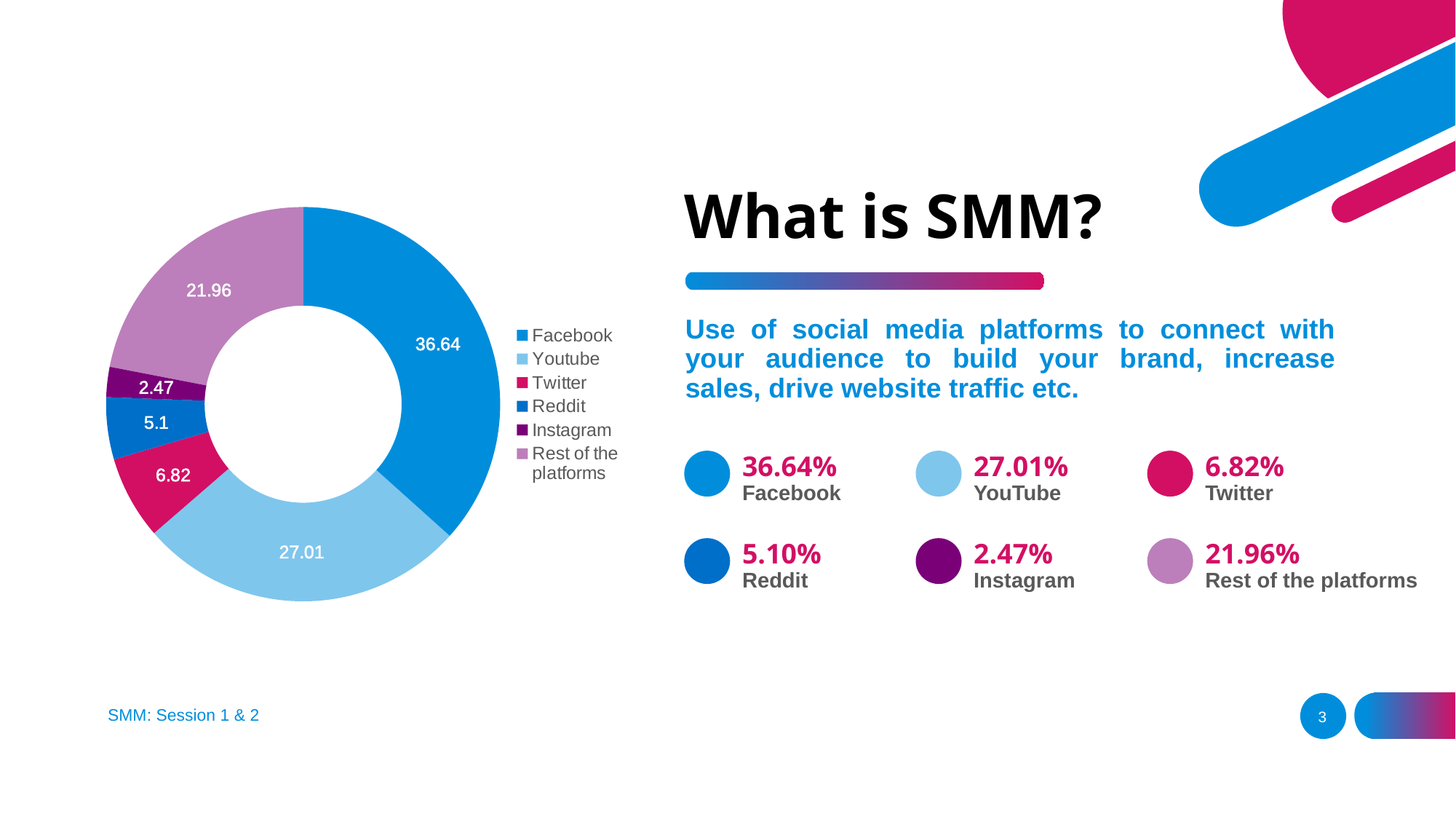
How many categories are shown in the doughnut chart? 6 What kind of chart is shown on the slide? Doughnut (pie) chart What value is shown for Youtube in the doughnut chart? 27.01 What value is shown for Facebook in the doughnut chart? 36.64 Which category has the largest slice in the doughnut chart? Facebook Which is larger in the doughnut chart, Twitter or Rest of the platforms? Rest of the platforms What value is shown for Rest of the platforms in the doughnut chart? 21.96 What value is shown for Reddit in the doughnut chart? 5.1 Which category has the smallest slice in the doughnut chart? Instagram What share of the doughnut chart does the Instagram slice represent? 2.47% What is the difference between the Facebook and Youtube values in the doughnut chart? 9.63 What is the difference between the Twitter and Reddit values in the doughnut chart? 1.72